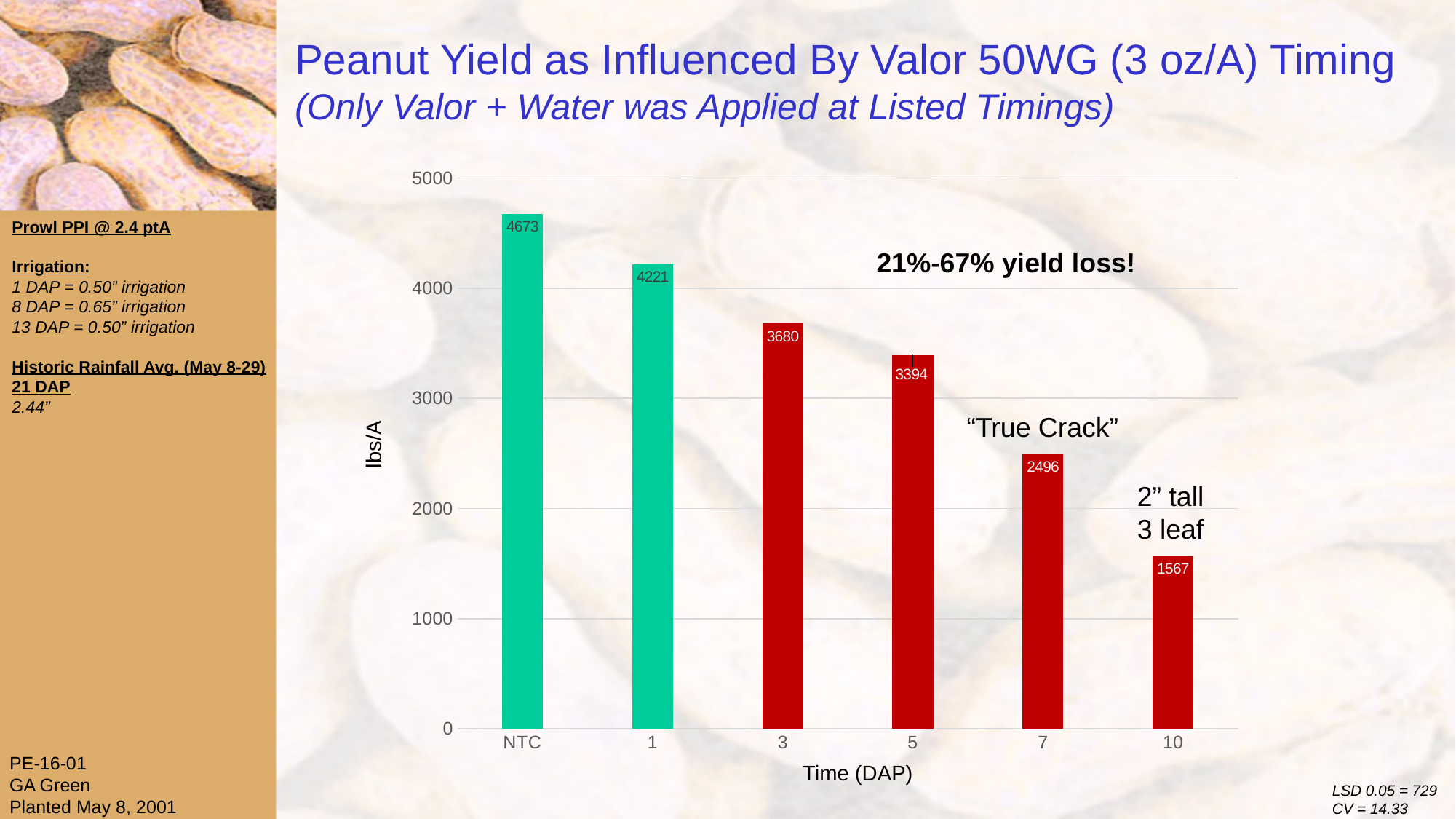
Do the yield values rise or fall as the application timing (DAP) increases along the x axis? fall What is the yield (lbs/A) at 10 DAP? 1567 Which timing category has the lowest yield? 10 What is the difference in yield between NTC and 10 DAP? 3106 What is the difference in yield between 1 DAP and 3 DAP? 541 Is the yield at 7 DAP greater or less than 3000? less How many bars are shown in the chart? 6 Which has a higher yield, 3 DAP or 7 DAP? 3 DAP What is the yield (lbs/A) at 5 DAP? 3394 What type of chart is shown on the slide? bar chart Which timing category has the highest yield? NTC What is the yield (lbs/A) for the NTC bar? 4673